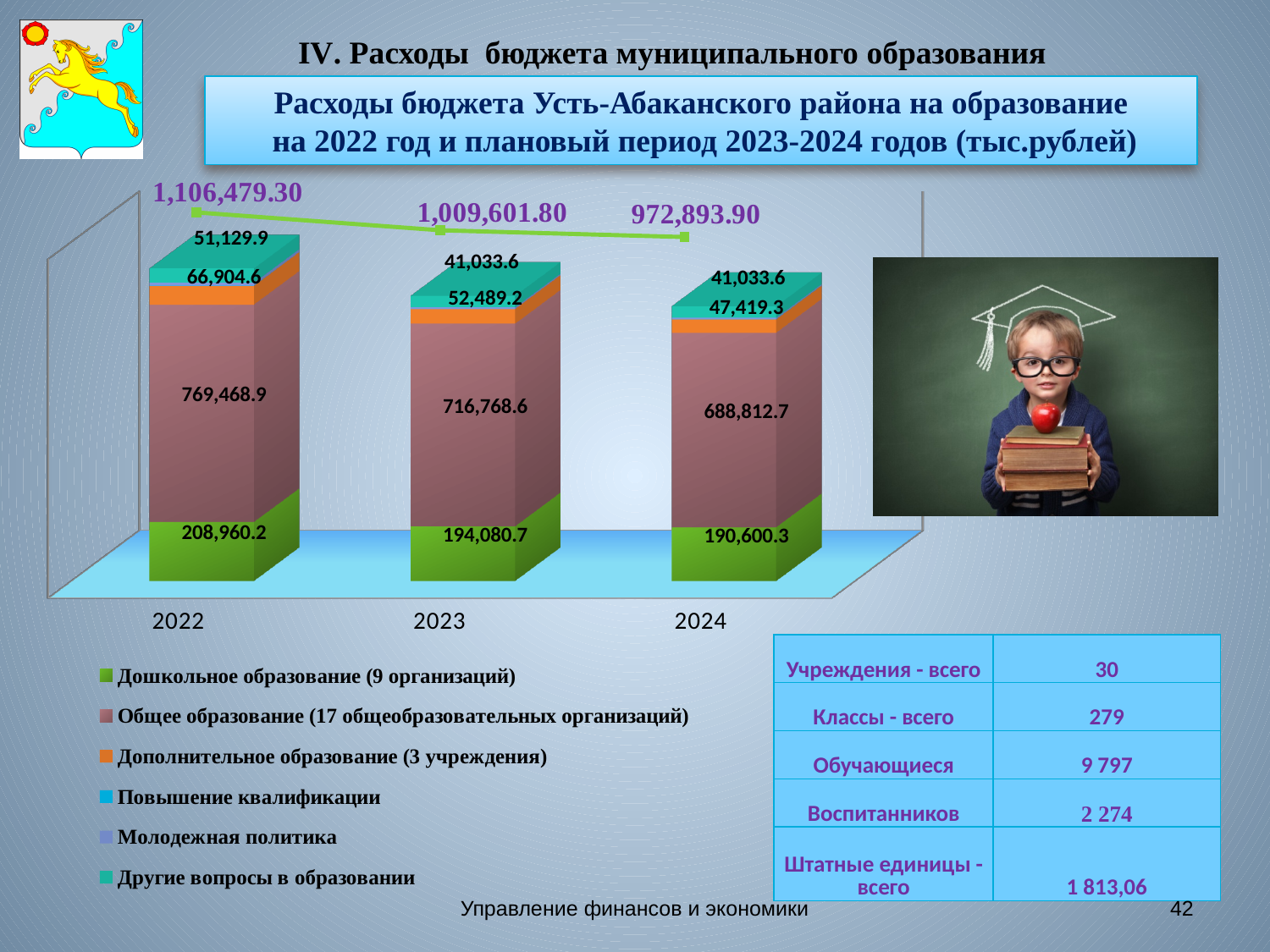
Which year has the larger value for Общее образование: 2022 or 2023? 2022 What is the total value shown above the bar for 2024? 972,893.90 How many years are shown on the x axis of the chart? 3 What is the difference between the Дошкольное образование values for 2022 and 2023? 14,879.5 What is the value for Общее образование (17 общеобразовательных организаций) in 2024? 688,812.7 Do the total values rise or fall from 2022 to 2024? fall What is the value for Общее образование (17 общеобразовательных организаций) in 2023? 716,768.6 What is the value for Дошкольное образование (9 организаций) in 2022? 208,960.2 Which year has the lowest value for Дошкольное образование (9 организаций)? 2024 Which year has the highest total expenditure on education? 2022 How many series does the legend list? 6 What is the total value shown above the bar for 2022? 1,106,479.30